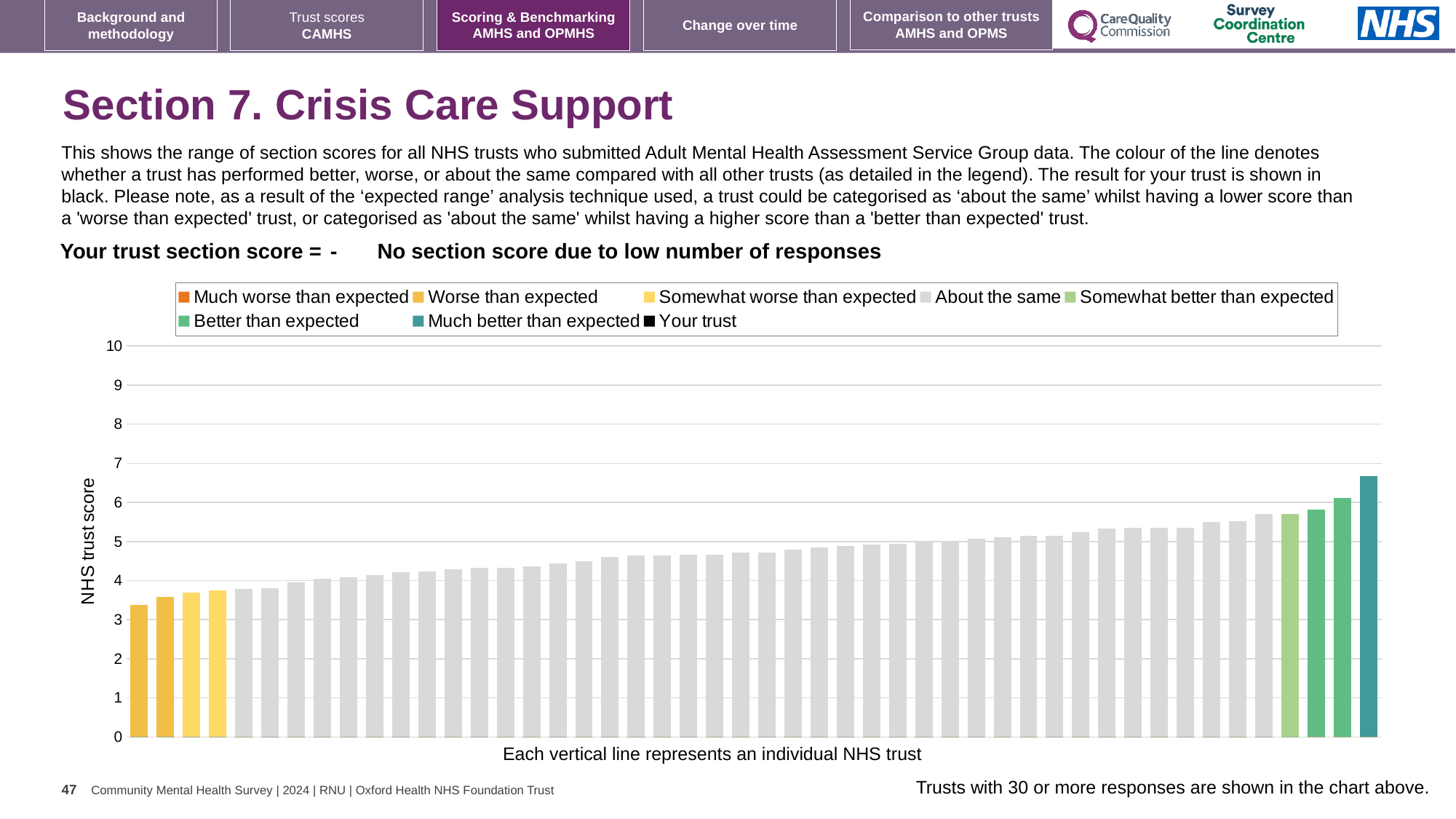
How many bars are coloured as 'Worse than expected'? 2 How many bars are coloured as 'Better than expected'? 2 Is the value of the shortest bar greater or less than 3? greater Is the value of the tallest bar greater or less than 6? greater How many bars are coloured as 'Much better than expected'? 1 What is the label on the y axis of the chart? NHS trust score What kind of chart is shown on the slide? bar chart Do the bar values rise or fall from left to right along the x axis? rise Is the value of the tallest bar greater or less than 7? less What does the slide give as your trust section score? - (No section score due to low number of responses) How many entries does the chart legend list? 8